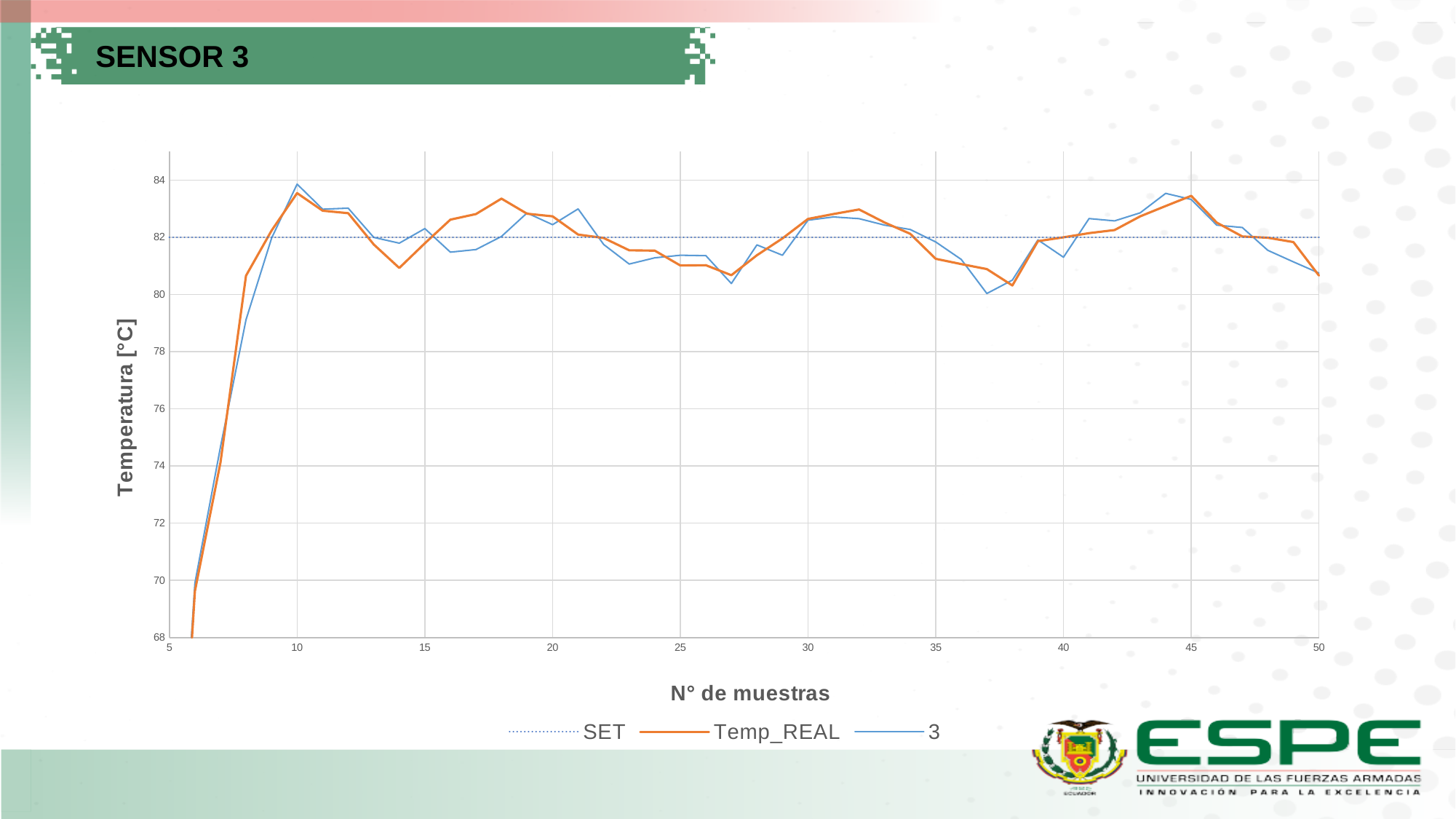
Is the Temp_REAL value at sample 10 greater or less than 82? greater What is the label of the y axis? Temperatura [°C] Between sample 6 and sample 10, does the Temp_REAL series rise or fall? rise Is the Temp_REAL value at sample 37 greater or less than 82? less Is the value of series 3 at sample 27 greater or less than 82? less What kind of chart is shown on the slide? line chart What are the names of the series listed in the legend? SET, Temp_REAL, 3 At sample 37, which series has the higher value, Temp_REAL or 3? Temp_REAL How many series does the legend list? 3 What constant value does the SET series hold across all samples? 82 At sample 14, which series has the higher value, Temp_REAL or 3? 3